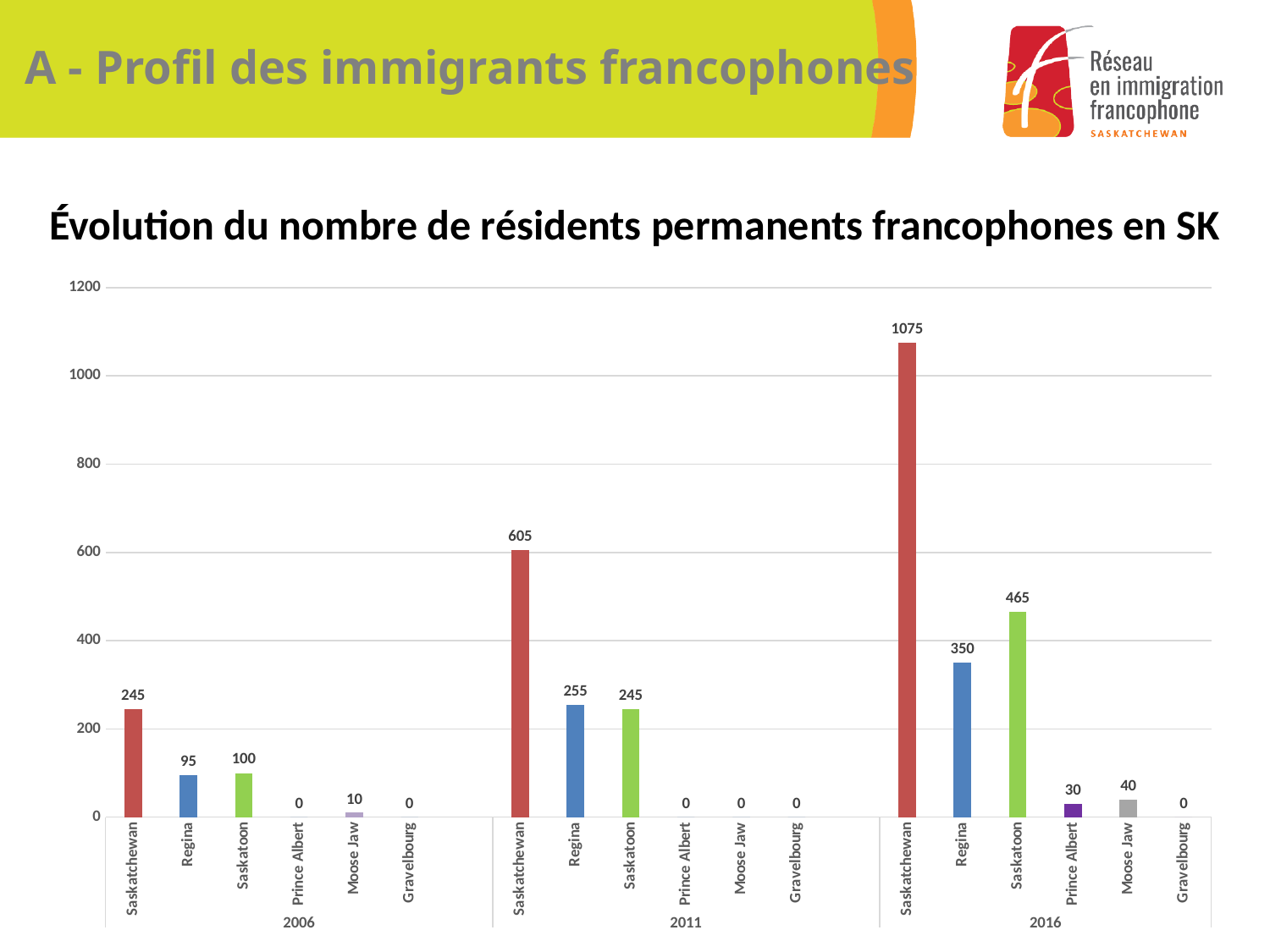
What kind of chart is shown on the slide? bar chart What is the value for Saskatchewan in 2016? 1075 What is the difference between Saskatoon and Regina in 2016? 115 What is the value for Regina in 2011? 255 Is the value for Saskatchewan in 2011 greater or less than 400? greater How many year groups are shown on the x axis? 3 What is the difference between the Saskatchewan values for 2016 and 2011? 470 What is the value for Moose Jaw in 2006? 10 Which bar has the highest value on the chart? Saskatchewan in 2016 Which is larger in 2006: Regina or Saskatoon? Saskatoon What is the value for Saskatoon in 2016? 465 Does the value for Saskatchewan rise or fall from 2006 to 2016? rise